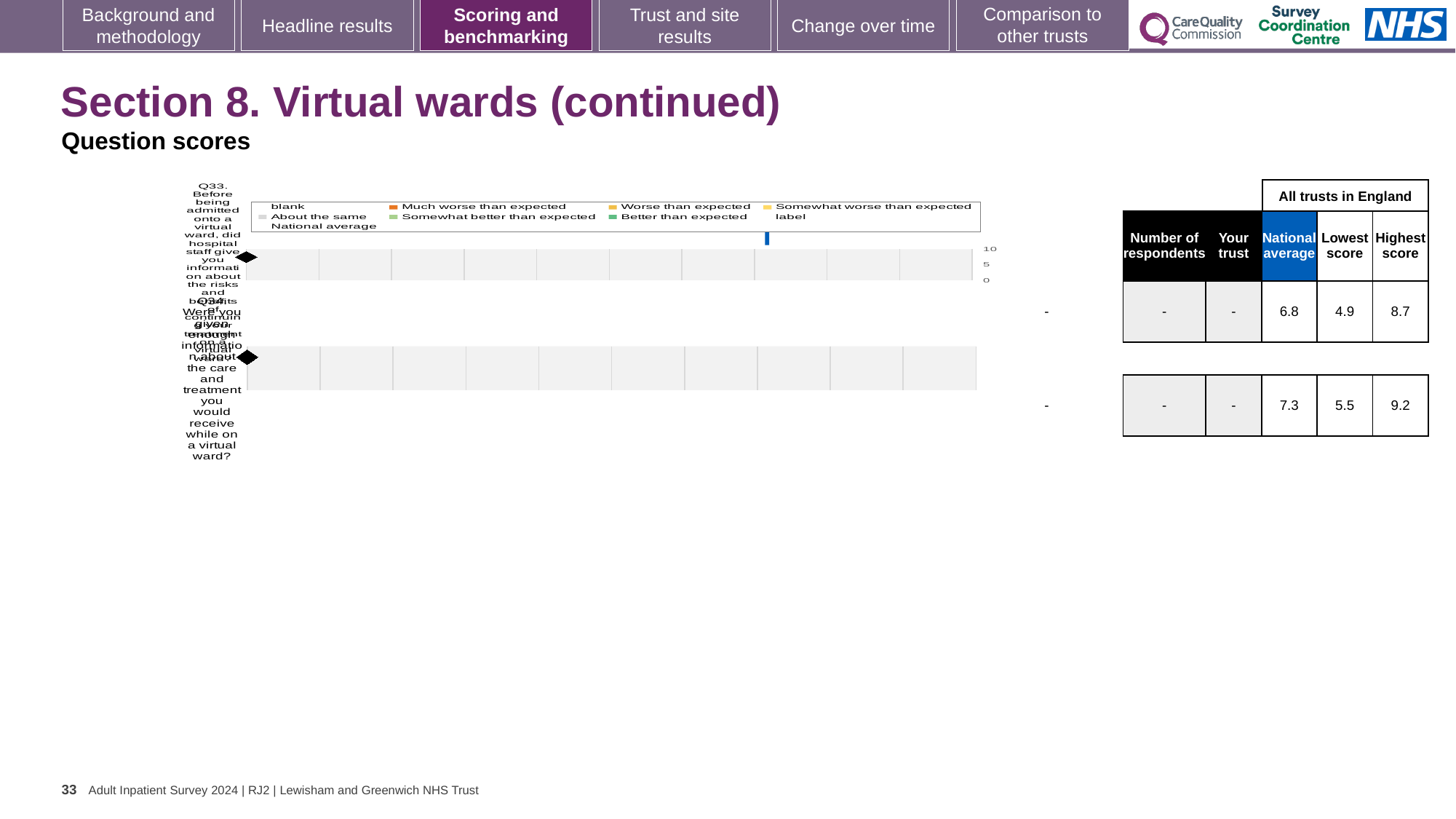
In the table next to the chart, which question has the higher national average, Q33 or Q34? Q34 In the table next to the chart, what is the highest score across all trusts in England for Q34? 9.2 In the table next to the chart, what is the difference between the highest and lowest scores for Q33? 3.8 In the table next to the chart, what is the national average score for Q34? 7.3 How many entries does the chart legend list? 9 In the table next to the chart, what is the lowest score across all trusts in England for Q33? 4.9 What is the highest tick value shown on the chart's x axis? 10 What kind of chart is shown on the slide? bar chart In the table next to the chart, what is the national average score for Q33? 6.8 Which legend entry is shown in orange on the chart? Much worse than expected How many questions (categories) are plotted on the chart? 2 In the table next to the chart, what value is shown for 'Your trust' for Q33? -